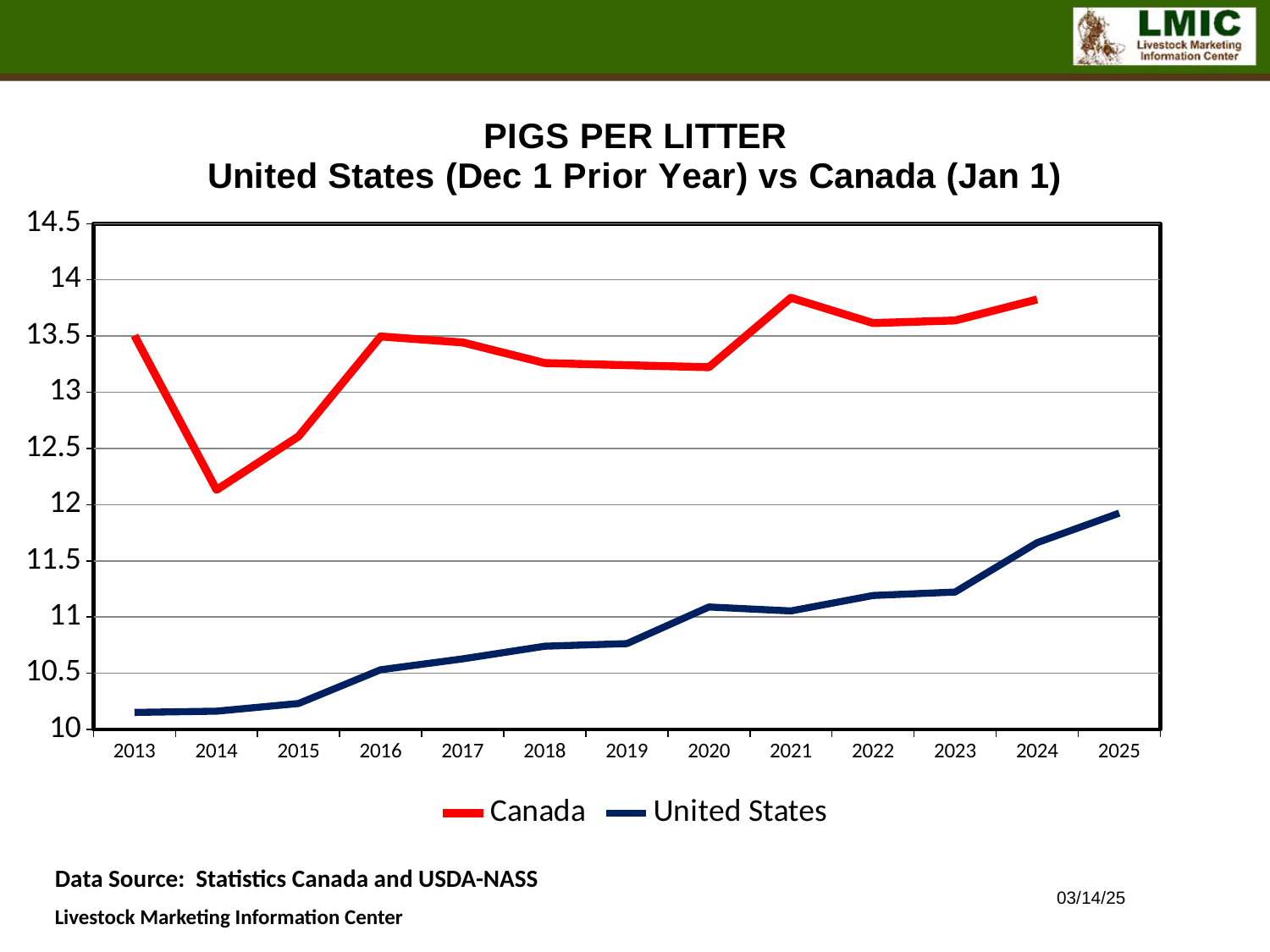
Is the Canada value for 2014 greater or less than 12.5? less In which year is the Canada value lowest? 2014 Is the Canada value for 2021 greater or less than 13.5? greater How many years are labeled on the x axis? 13 Is the United States value for 2025 greater or less than 12? less What is the title of the chart? PIGS PER LITTER United States (Dec 1 Prior Year) vs Canada (Jan 1) In which year is the United States value highest? 2025 What kind of chart is shown on the slide? Line chart Which series is drawn in red? Canada Does the United States series generally rise or fall from 2013 to 2025? rise Which is larger in 2020, the Canada value or the United States value? Canada How many series does the legend list? 2